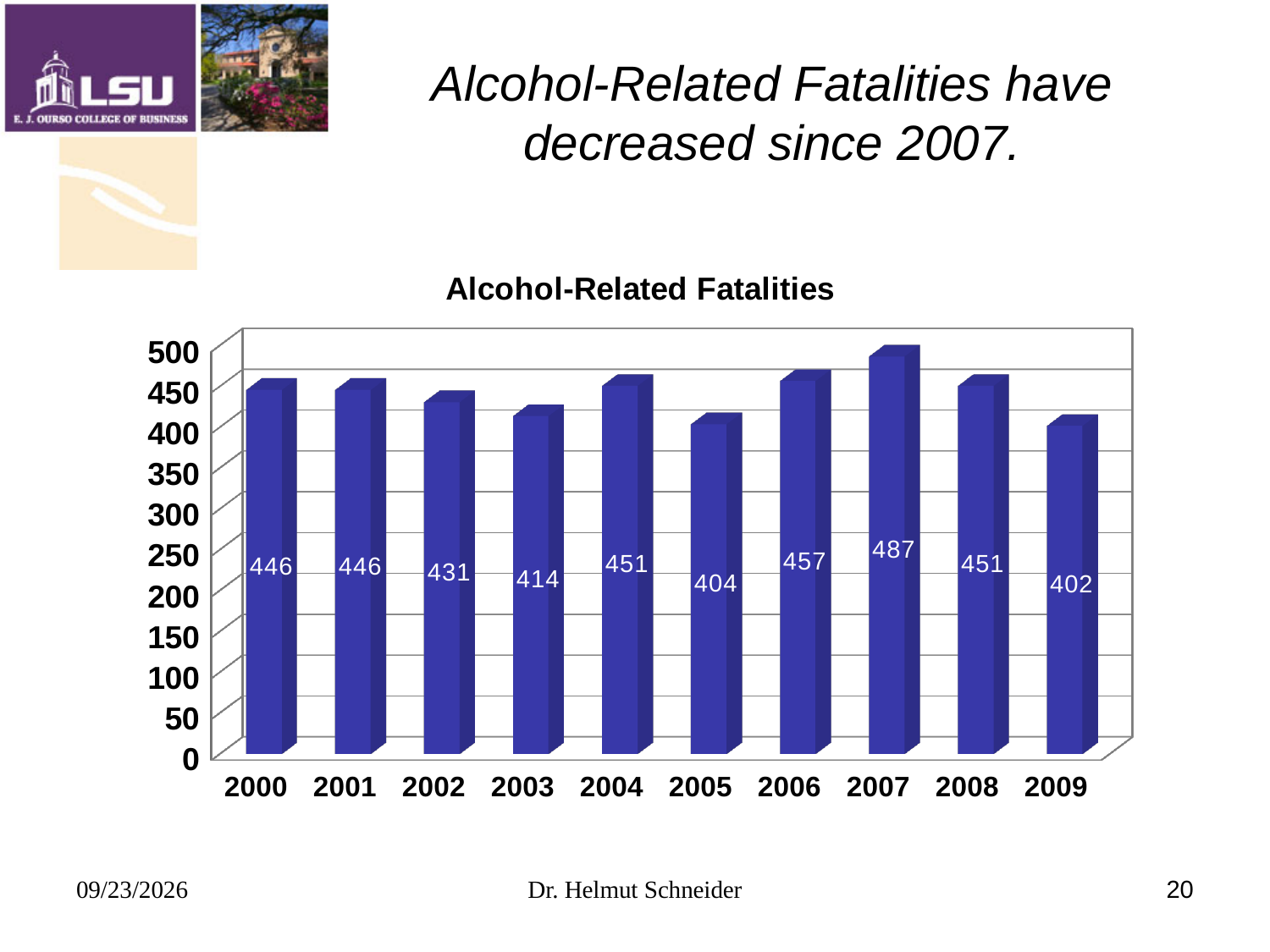
What is the value for 2009? 402 What is the difference between the values for 2007 and 2009? 85 What is the value for 2007? 487 What is the title of the chart? Alcohol-Related Fatalities Which year has the lowest number of alcohol-related fatalities? 2009 What kind of chart is shown on the slide? bar chart Which year has the highest number of alcohol-related fatalities? 2007 What is the difference between the values for 2006 and 2005? 53 How many years are shown on the x axis? 10 Which is larger, the value for 2004 or the value for 2002? 2004 What is the value for 2003? 414 Is the value for 2005 greater or less than 450? less